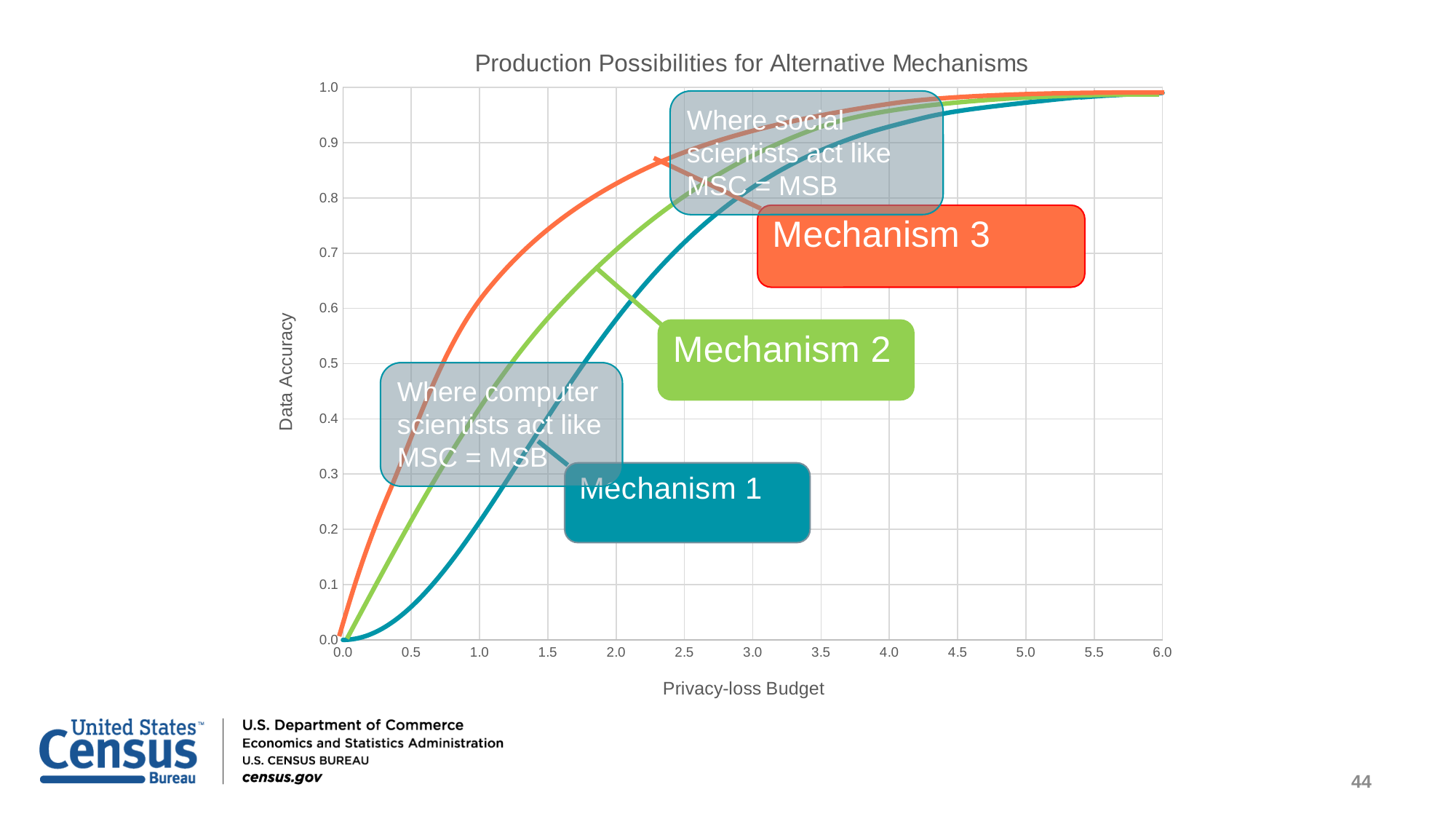
What kind of chart is shown on the slide? Line chart How many mechanism curves are plotted on the chart? 3 What is the label of the x axis? Privacy-loss Budget Is the Data Accuracy for Mechanism 2 at a Privacy-loss Budget of 2.0 greater or less than 0.6? greater What is the title of the chart? Production Possibilities for Alternative Mechanisms Does Data Accuracy rise or fall as the Privacy-loss Budget increases for Mechanism 1? Rises Which mechanism has the lowest Data Accuracy at a Privacy-loss Budget of 1.0? Mechanism 1 At a Privacy-loss Budget of 2.0, which has higher Data Accuracy, Mechanism 2 or Mechanism 1? Mechanism 2 Which mechanism has the highest Data Accuracy at a Privacy-loss Budget of 1.0? Mechanism 3 What is the maximum value shown on the Privacy-loss Budget axis? 6.0 Is the Data Accuracy for Mechanism 3 at a Privacy-loss Budget of 1.0 greater or less than 0.6? greater Is the Data Accuracy for Mechanism 1 at a Privacy-loss Budget of 1.0 greater or less than 0.4? less